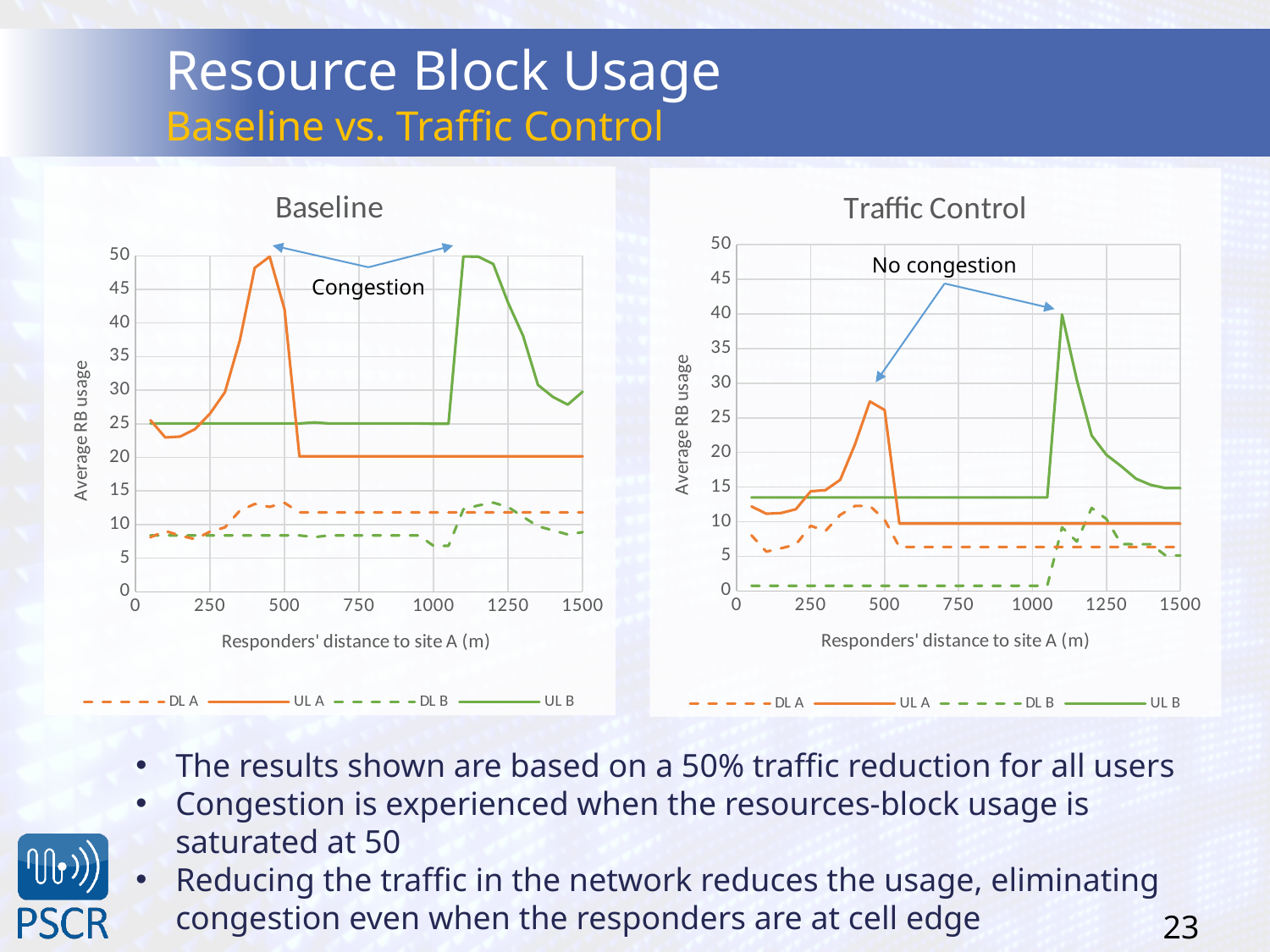
In the Traffic Control chart, is the peak value of UL B greater or less than 35? greater What is the y-axis title of the Traffic Control chart? Average RB usage In the Traffic Control chart, is the peak value of UL A greater or less than 30? less In the Traffic Control chart, which series reaches the highest value? UL B What kind of chart is the Baseline chart? line chart In the Baseline chart, at a distance of 1500 m, which is higher: UL A or UL B? UL B In the Baseline chart, is the peak value of UL A greater or less than 40? greater What are the legend entries of the Baseline chart? DL A, UL A, DL B, UL B In the Traffic Control chart, does the UL B series rise or fall between 1100 m and 1500 m? fall How many series does the legend of the Traffic Control chart list? 4